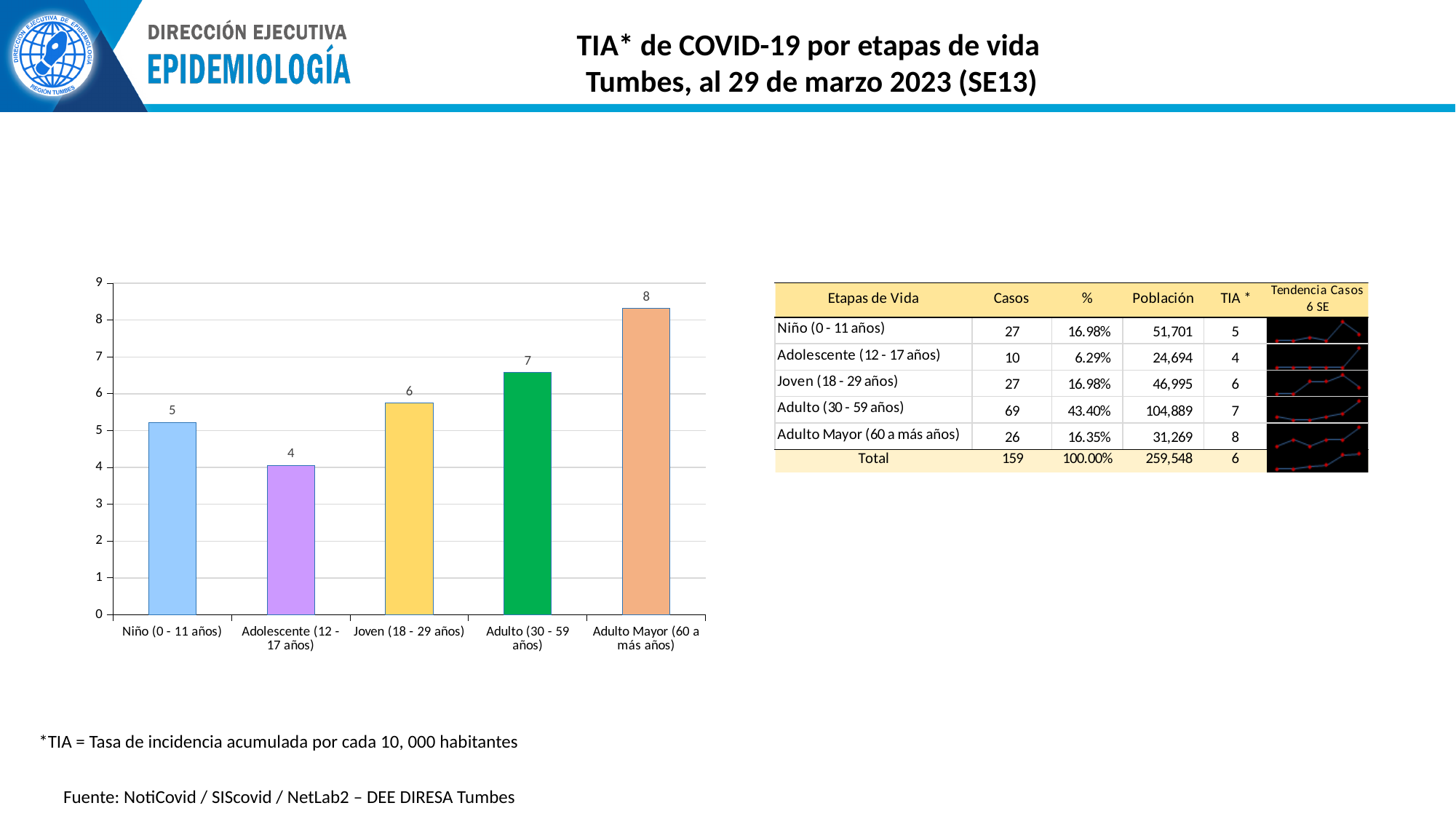
What is the data label shown for Adulto Mayor (60 a más años) in the bar chart? 8 Using the data labels, what is the difference between the values for Adulto Mayor (60 a más años) and Adolescente (12 - 17 años)? 4 What is the data label shown for Adolescente (12 - 17 años) in the bar chart? 4 What type of chart is shown on the slide? bar chart Which is larger in the bar chart, the value for Joven (18 - 29 años) or the value for Adulto (30 - 59 años)? Adulto (30 - 59 años) Which category has the lowest bar in the chart? Adolescente (12 - 17 años) What is the maximum value shown on the vertical axis of the bar chart? 9 How many age-group categories are plotted in the bar chart? 5 What is the data label shown for Adulto (30 - 59 años) in the bar chart? 7 What is the data label shown for Niño (0 - 11 años) in the bar chart? 5 Which category has the highest bar in the chart? Adulto Mayor (60 a más años)